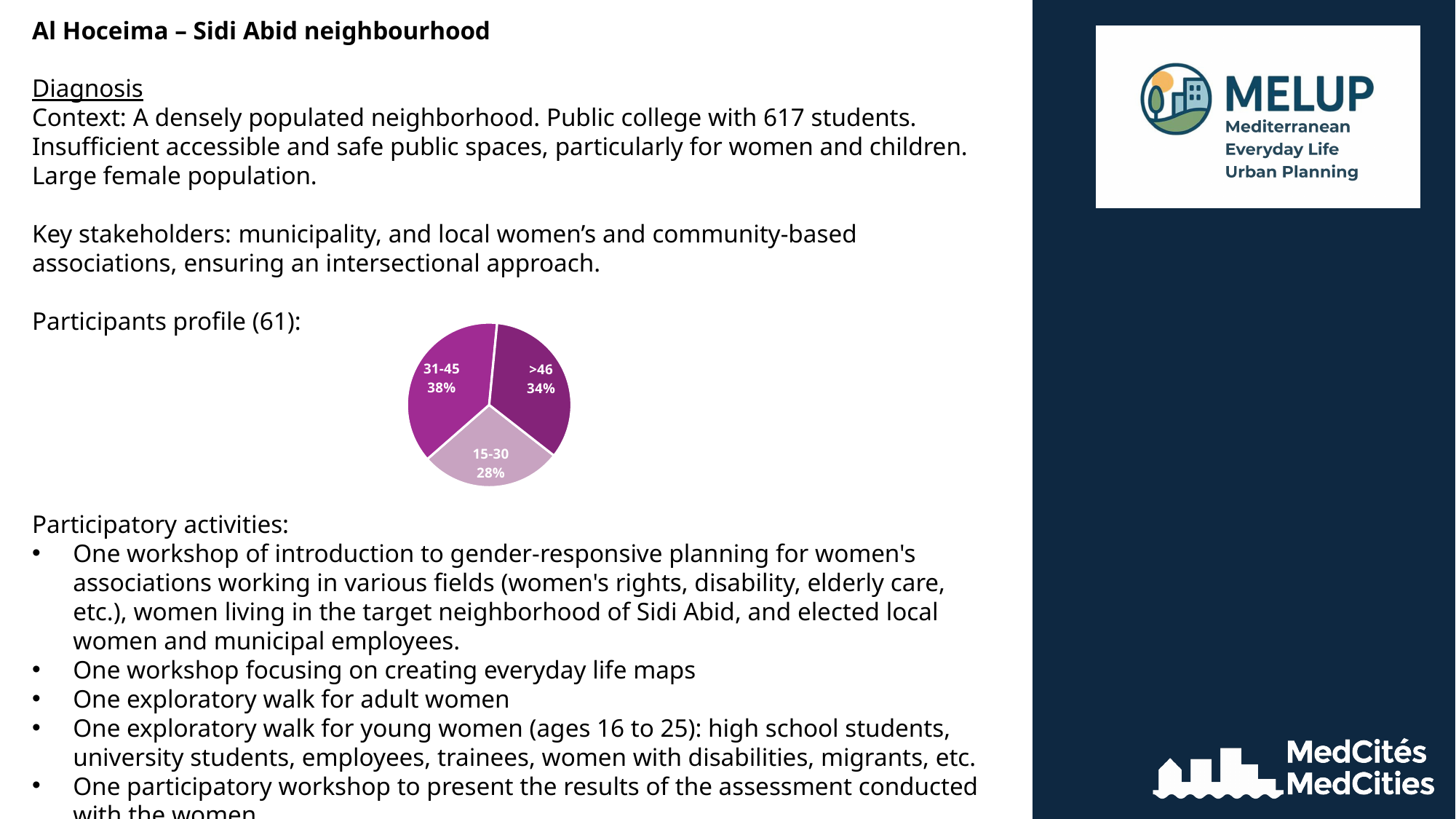
Which age group has the smallest share of participants? 15-30 How many age groups are shown in the pie chart? 3 What is the difference in percentage points between the 31-45 and 15-30 age groups? 10 Which age group has a larger share, 31-45 or >46? 31-45 Which age group has the largest share of participants? 31-45 How many participants does the profile cover, according to the text above the chart? 61 What share of participants are in the >46 age group? 34% What is the difference in percentage points between the >46 and 15-30 age groups? 6 What share of participants are in the 31-45 age group? 38% What share of participants are in the 15-30 age group? 28% What kind of chart is shown on the slide? pie chart Which age group's slice is shown in the lightest colour? 15-30